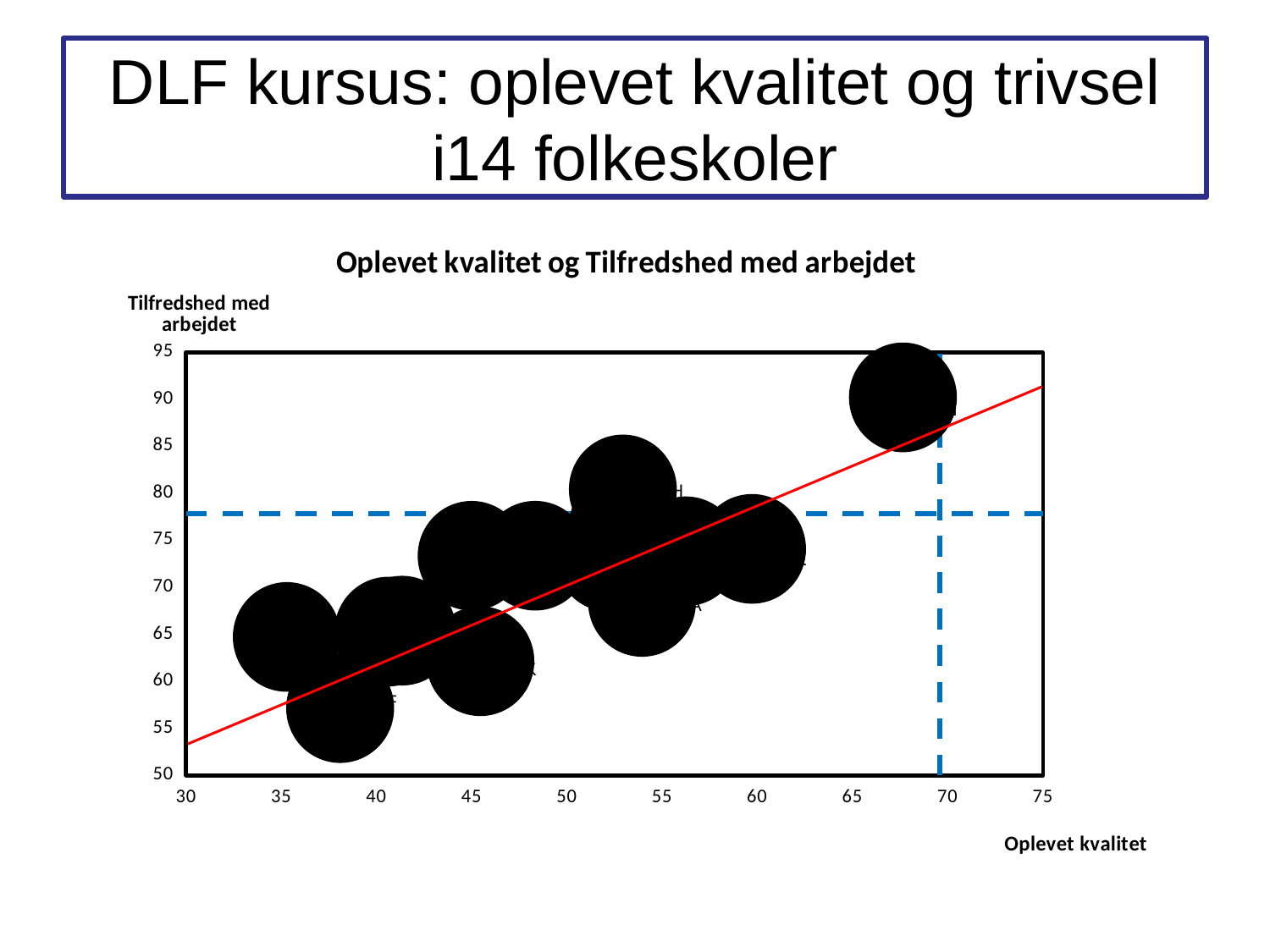
What is the label of the vertical axis of the chart? Tilfredshed med arbejdet What is the title of the chart? Oplevet kvalitet og Tilfredshed med arbejdet Do the plotted points generally rise or fall as Oplevet kvalitet increases along the x axis? rise What kind of chart is shown on the slide? scatter chart Is the Oplevet kvalitet value of the lowest point on the chart greater or less than 45? less Is the Oplevet kvalitet value of the highest point on the chart greater or less than 65? greater Is the Tilfredshed med arbejdet value of the highest point on the chart greater or less than 85? greater